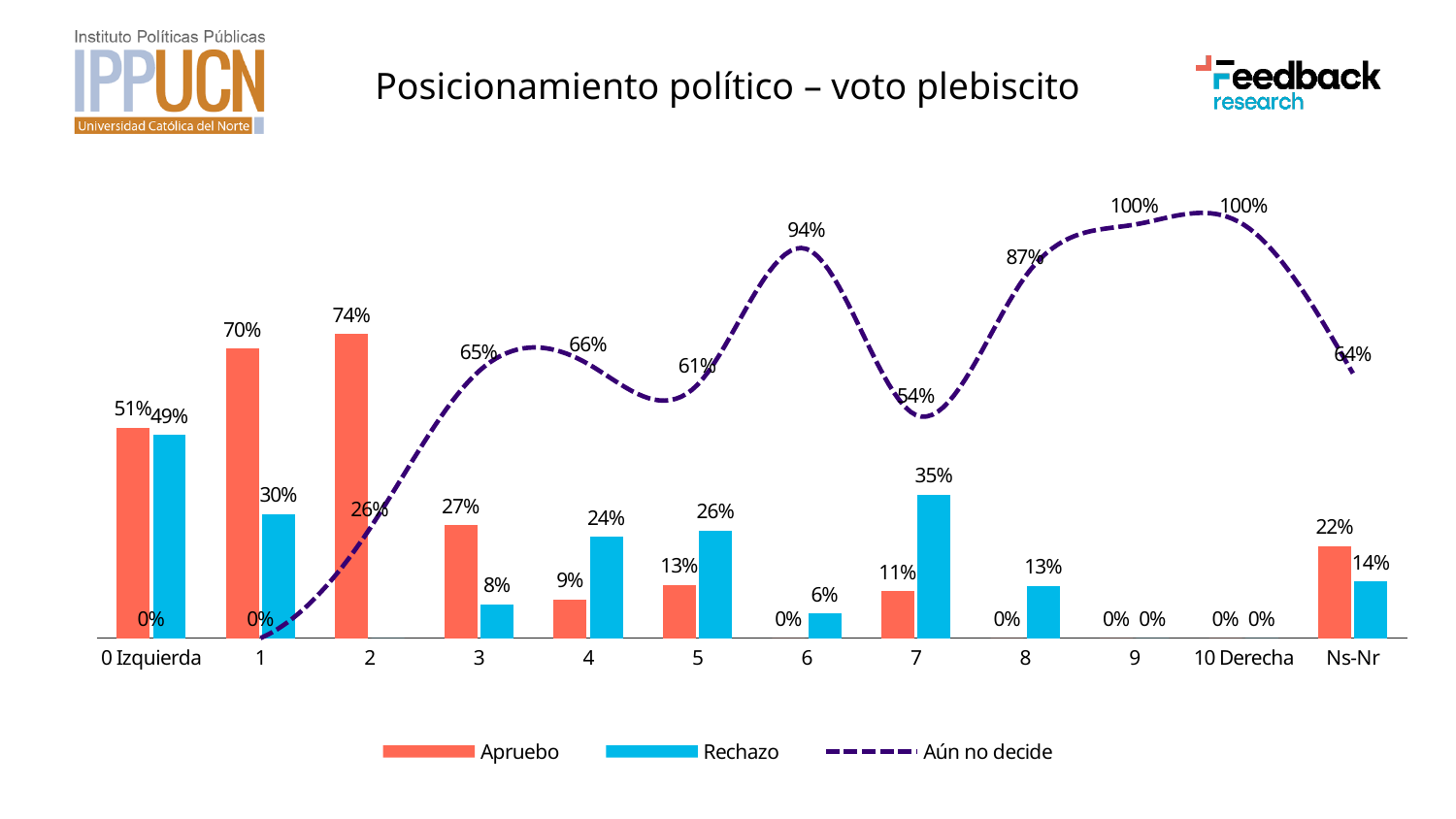
What is the Rechazo value for category 7? 35% What is the difference between the Apruebo and Rechazo values for category 1? 40% What is the Apruebo value for category 2? 74% What is the Apruebo value for Ns-Nr? 22% How many categories are shown on the x axis? 12 How many series does the legend list? 3 What type of chart is used for the Apruebo and Rechazo series? Bar chart Which is larger for category 4, Apruebo or Rechazo? Rechazo Which category has the highest Rechazo value? 7 Which category has the highest Apruebo value? 2 What is the Aún no decide value for category 6? 94% What is the title of the chart? Posicionamiento político – voto plebiscito